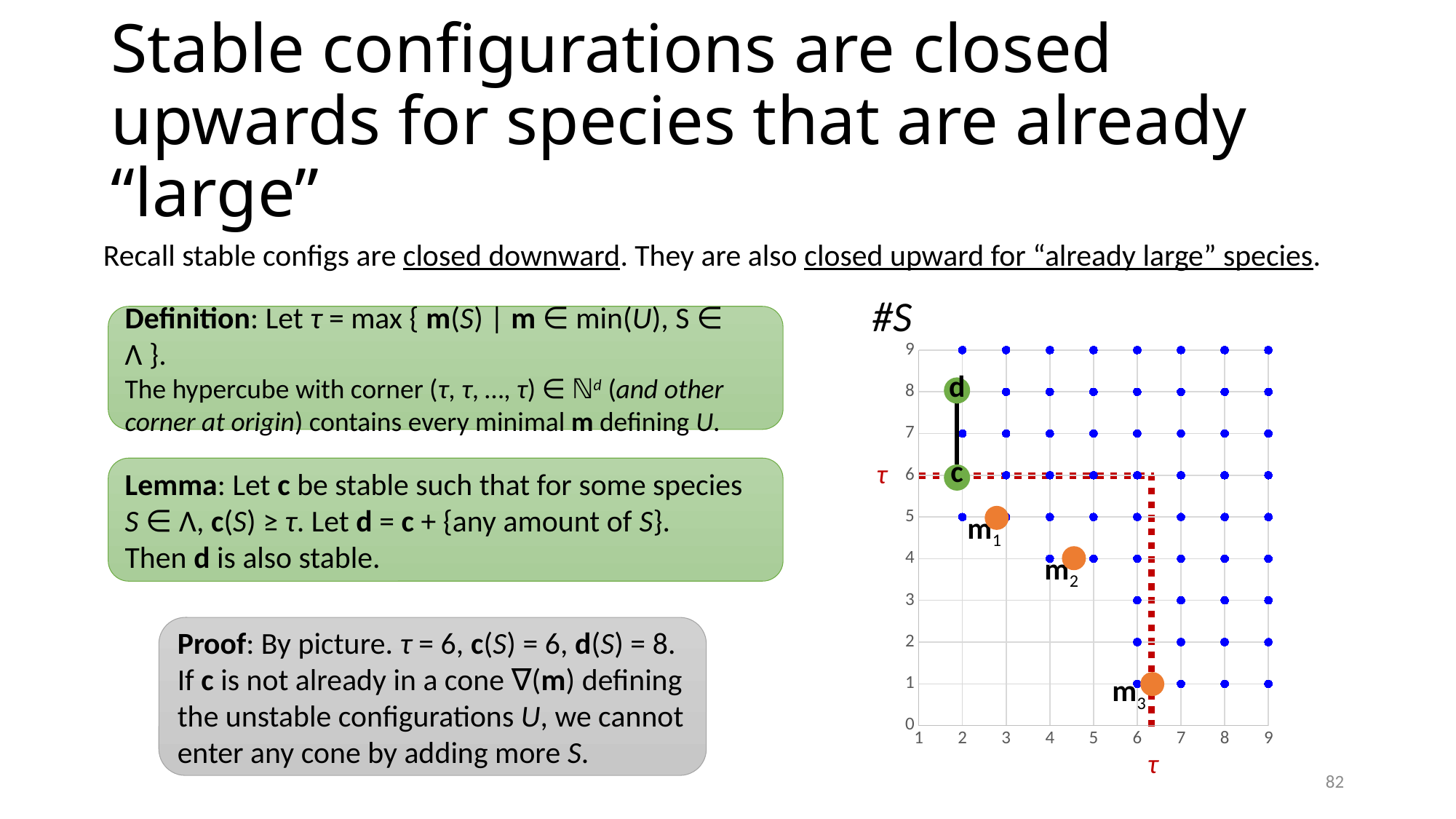
What is the label on the vertical axis of the chart? #S What value on the axes is marked by the red dashed lines labelled τ? 6 Is the #S value of the point d greater or less than 7? greater What kind of chart is shown on the right of the slide? scatter chart Which point has the larger #S value, c or d? d Among the orange points m1, m2 and m3, which has the lowest #S value? m3 Is the #S value of the point m3 greater or less than 3? less What is the highest tick value shown on the vertical axis? 9 What is the #S value of the point labelled d? 8 What is the difference in #S between the points d and c? 2 What is the #S value of the point labelled c? 6 How many labelled points (c, d, m1, m2, m3) are marked on the chart? 5